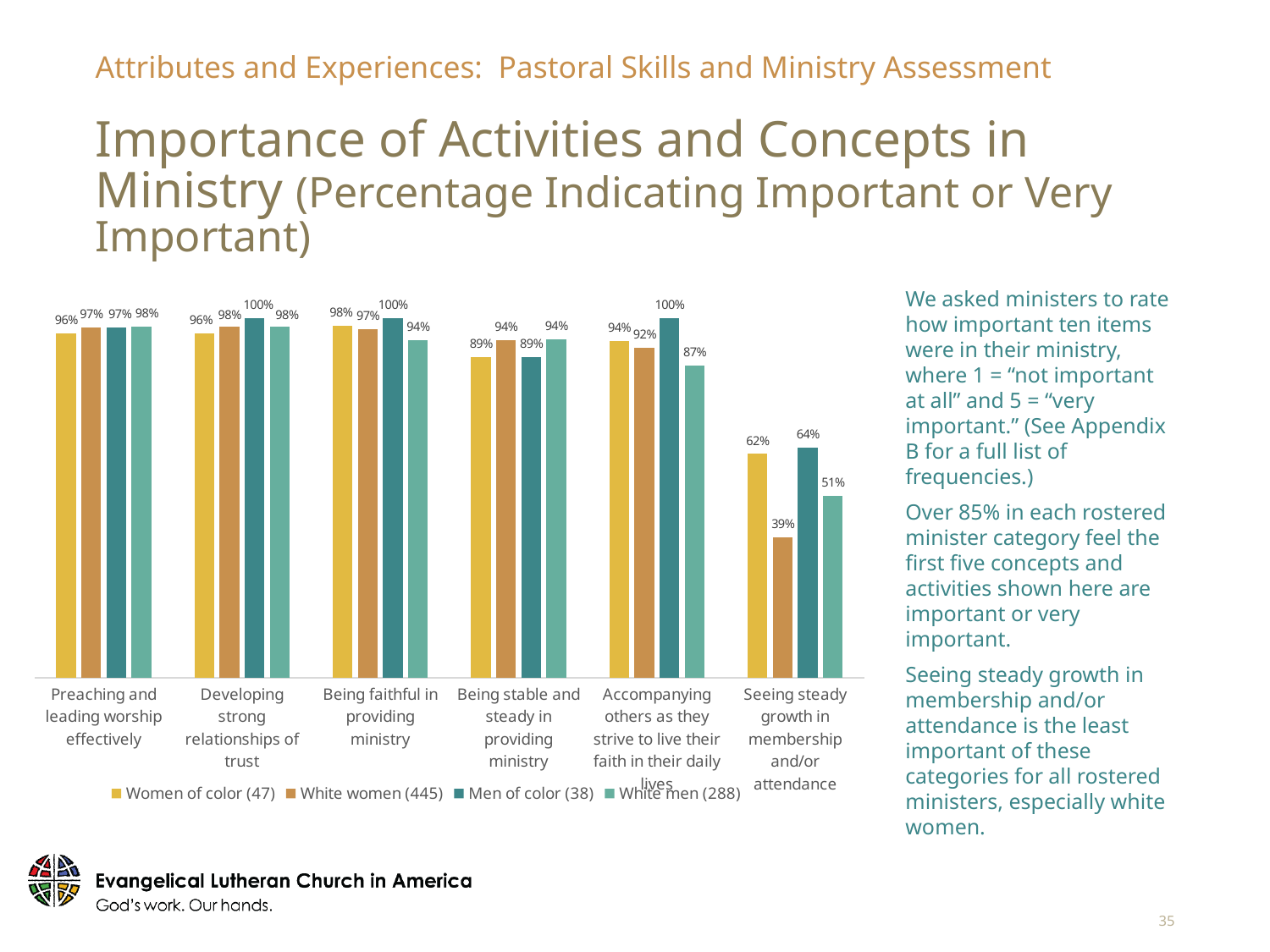
Which group has the highest value for "Seeing steady growth in membership and/or attendance"? Men of color (38) What is the difference between the Men of color and White women values for "Seeing steady growth in membership and/or attendance"? 25% What percentage of White women rated "Seeing steady growth in membership and/or attendance" as important or very important? 39% For "Accompanying others as they strive to live their faith in their daily lives", which is larger: the value for Women of color or for White men? Women of color How many series does the legend list? 4 What is the value for White men for "Being faithful in providing ministry"? 94% How many categories are shown on the x axis of the chart? 6 What is the value for Men of color for "Accompanying others as they strive to live their faith in their daily lives"? 100% What is the value for Women of color for "Being stable and steady in providing ministry"? 89% What is the sample size shown in the legend for White women? 445 Which category has the lowest value for White women? Seeing steady growth in membership and/or attendance What kind of chart is shown on the slide? Bar chart